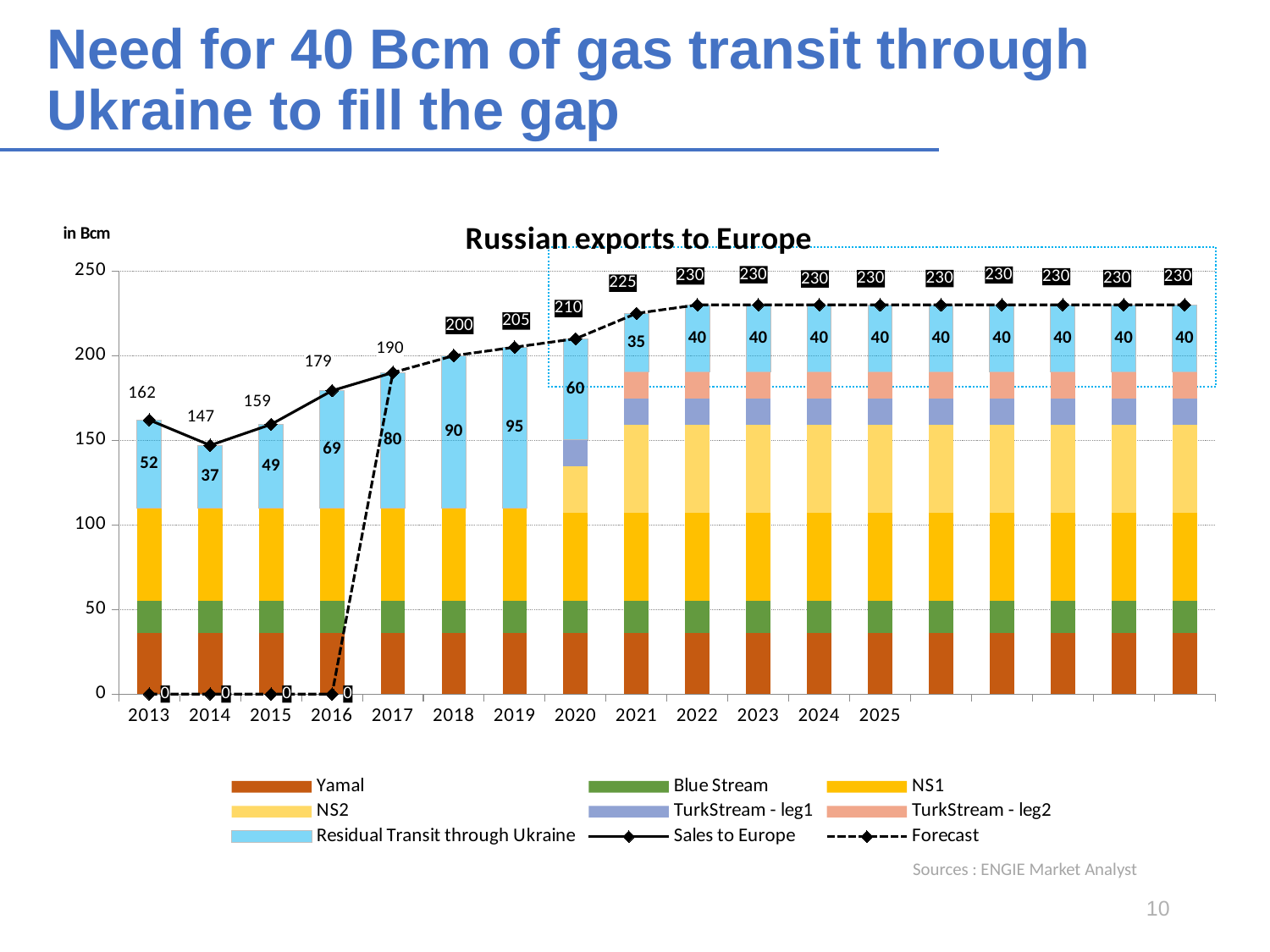
Which year has the larger Residual Transit through Ukraine value, 2018 or 2020? 2018 What is the title of the chart? Russian exports to Europe How many series does the legend list? 9 Between 2013 and 2017, in which year is Sales to Europe lowest? 2014 What is the Forecast value for 2020? 210 How much higher is Sales to Europe in 2017 than in 2013? 28 What is the Residual Transit through Ukraine value in 2021? 35 Is the Yamal value in 2013 greater or less than 50? less What is the Sales to Europe value in 2014? 147 Between 2013 and 2017, in which year is Sales to Europe highest? 2017 Does the Forecast line rise or fall from 2018 to 2022? rise What is the value of Residual Transit through Ukraine in 2013? 52